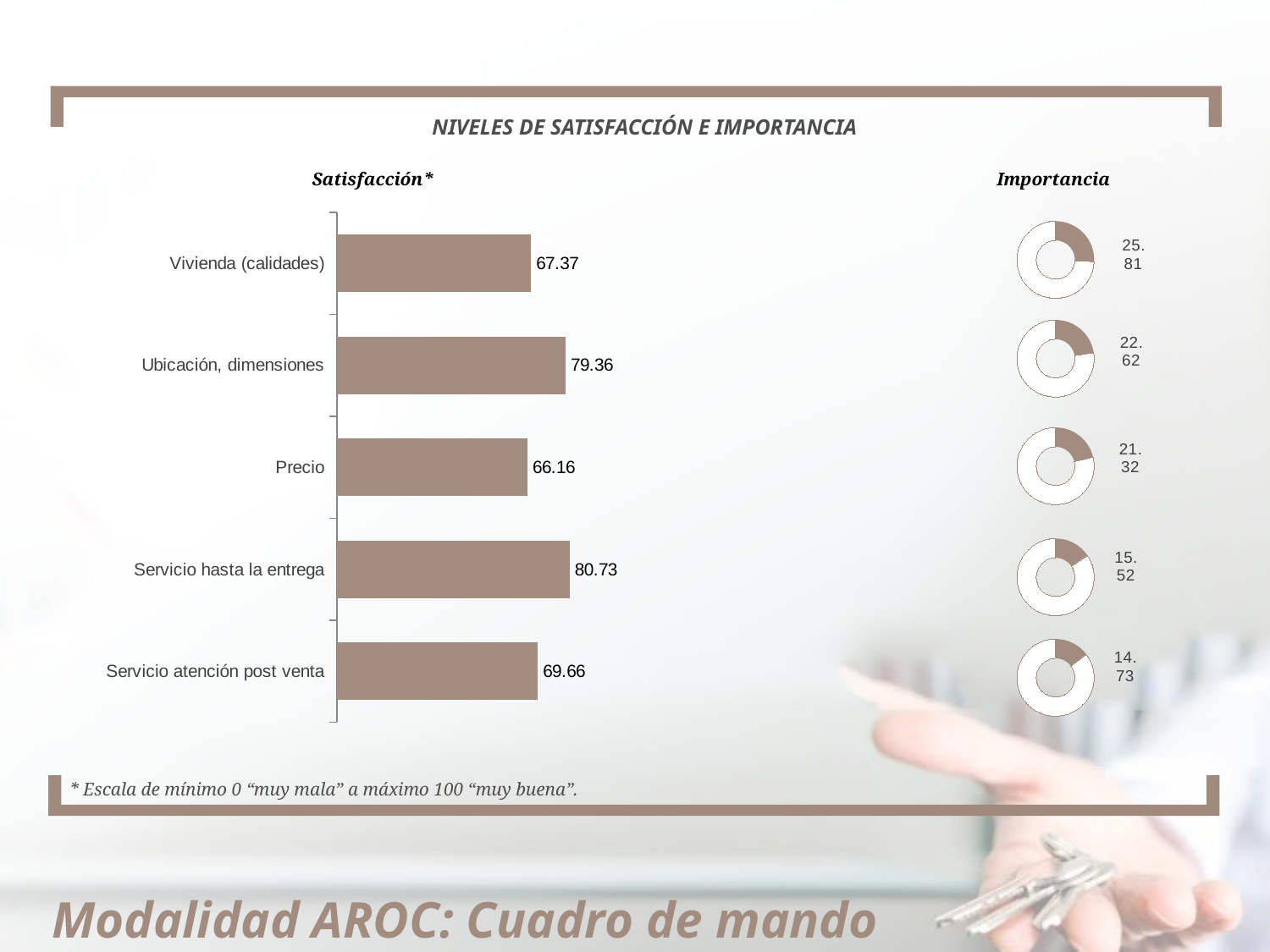
In the Importancia donut charts, which category has the lowest value? Servicio atención post venta In the Satisfacción chart, which category has the lowest value? Precio What kind of chart is the Satisfacción chart? Bar chart In the Satisfacción chart, which category has the highest value? Servicio hasta la entrega In the Satisfacción chart, what is the difference between Servicio hasta la entrega and Precio? 14.57 How many categories are shown in the Satisfacción chart? 5 In the Satisfacción chart, what is the difference between Ubicación, dimensiones and Vivienda (calidades)? 11.99 In the Importancia donut charts, what is the value shown for Vivienda (calidades)? 25.81 In the Satisfacción chart, which is larger: Vivienda (calidades) or Precio? Vivienda (calidades) In the Satisfacción chart, what is the value for Servicio atención post venta? 69.66 In the Satisfacción chart, what is the value for Precio? 66.16 In the Satisfacción chart, what is the value for Ubicación, dimensiones? 79.36